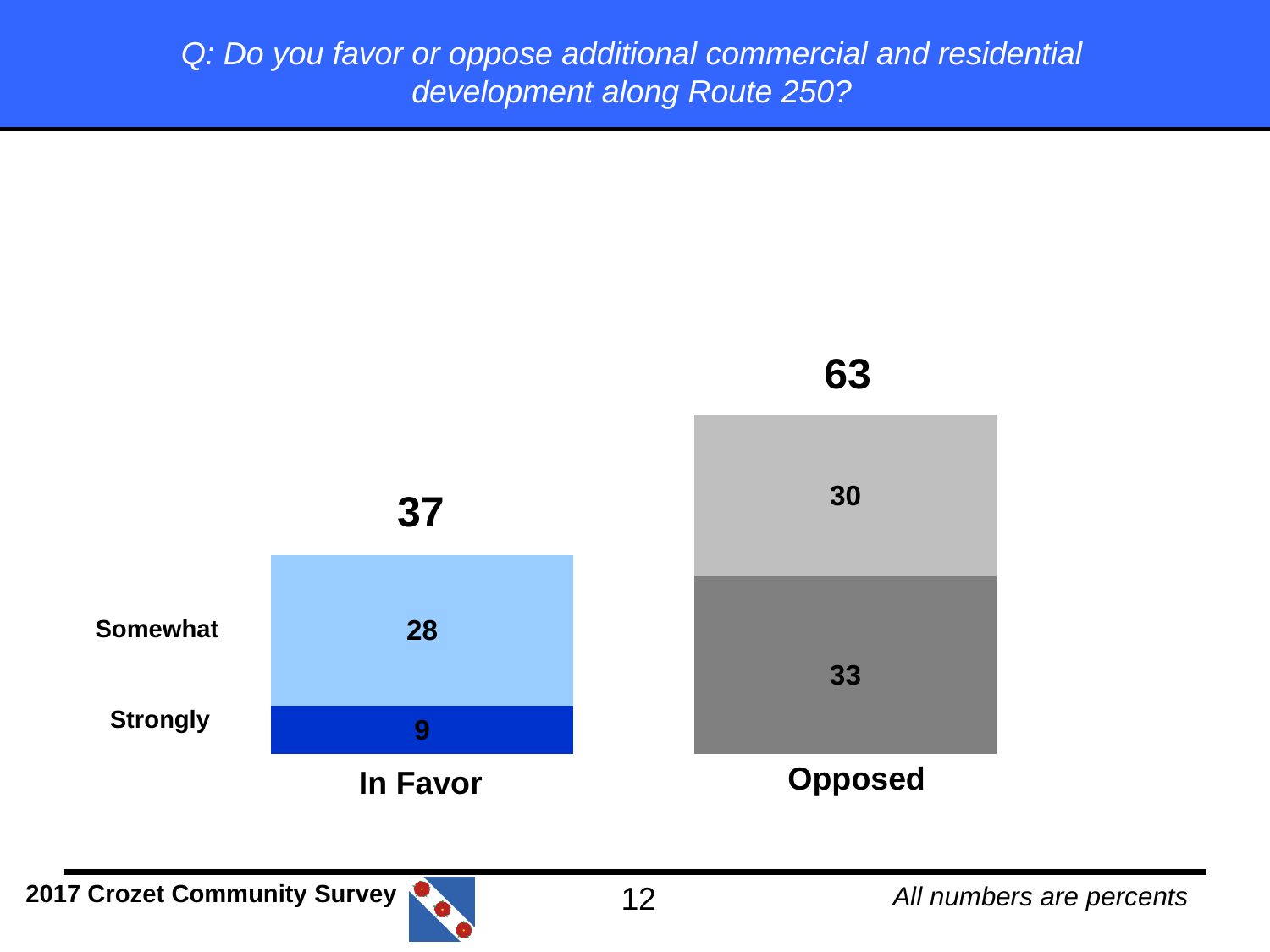
What is the difference between the Opposed total and the In Favor total? 26 What is the Somewhat value for Opposed? 30 What is the Strongly value for In Favor? 9 What is the total value of the In Favor bar? 37 What is the total value of the Opposed bar? 63 Which category has the higher total, In Favor or Opposed? Opposed What kind of chart is shown on the slide? stacked bar chart What is the Strongly value for Opposed? 33 What is the difference between the Strongly values for Opposed and In Favor? 24 What question does the chart title say the survey asked? Do you favor or oppose additional commercial and residential development along Route 250? What is the Somewhat value for In Favor? 28 How many categories are shown on the x axis of the chart? 2